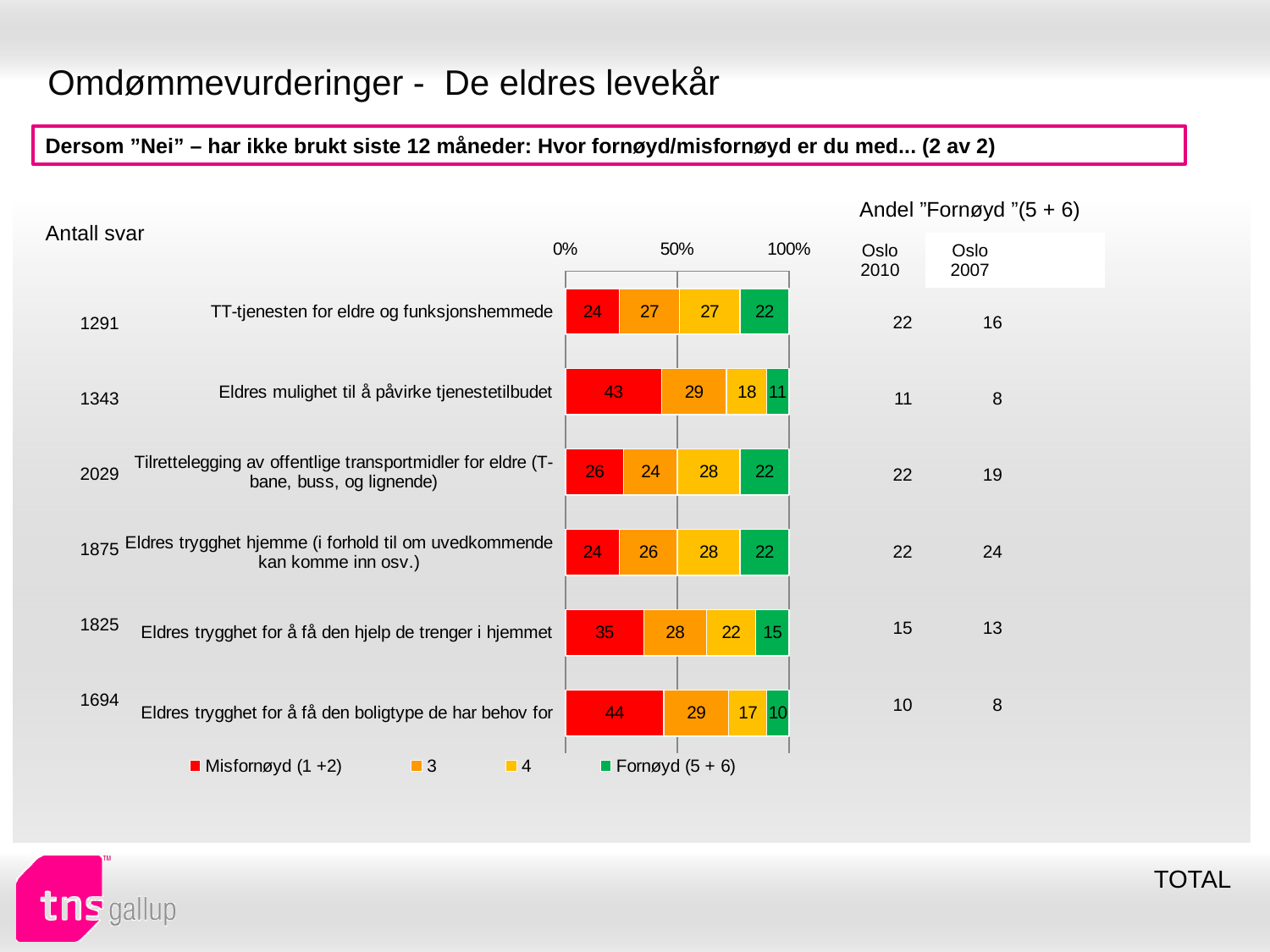
How many series does the chart legend list? 4 What is the difference between the Misfornøyd (1 +2) values for 'Eldres mulighet til å påvirke tjenestetilbudet' and 'TT-tjenesten for eldre og funksjonshemmede'? 19 Which category has the lowest Fornøyd (5 + 6) value? Eldres trygghet for å få den boligtype de har behov for Which is larger: the Fornøyd (5 + 6) value for 'Eldres trygghet for å få den hjelp de trenger i hjemmet' or for 'Eldres trygghet hjemme (i forhold til om uvedkommende kan komme inn osv.)'? Eldres trygghet hjemme (i forhold til om uvedkommende kan komme inn osv.) What is the total of the stacked bar for 'Tilrettelegging av offentlige transportmidler for eldre (T-bane, buss, og lignende)'? 100 What is the Fornøyd (5 + 6) value for 'TT-tjenesten for eldre og funksjonshemmede'? 22 What kind of chart is shown on the slide? Stacked bar chart How many categories (statements) are plotted in the chart? 6 What is the Misfornøyd (1 +2) value for 'Eldres trygghet for å få den boligtype de har behov for'? 44 What is the value of series '3' for 'Eldres mulighet til å påvirke tjenestetilbudet'? 29 Which category has the highest Misfornøyd (1 +2) value? Eldres trygghet for å få den boligtype de har behov for What colour represents the Fornøyd (5 + 6) series in the chart? Green